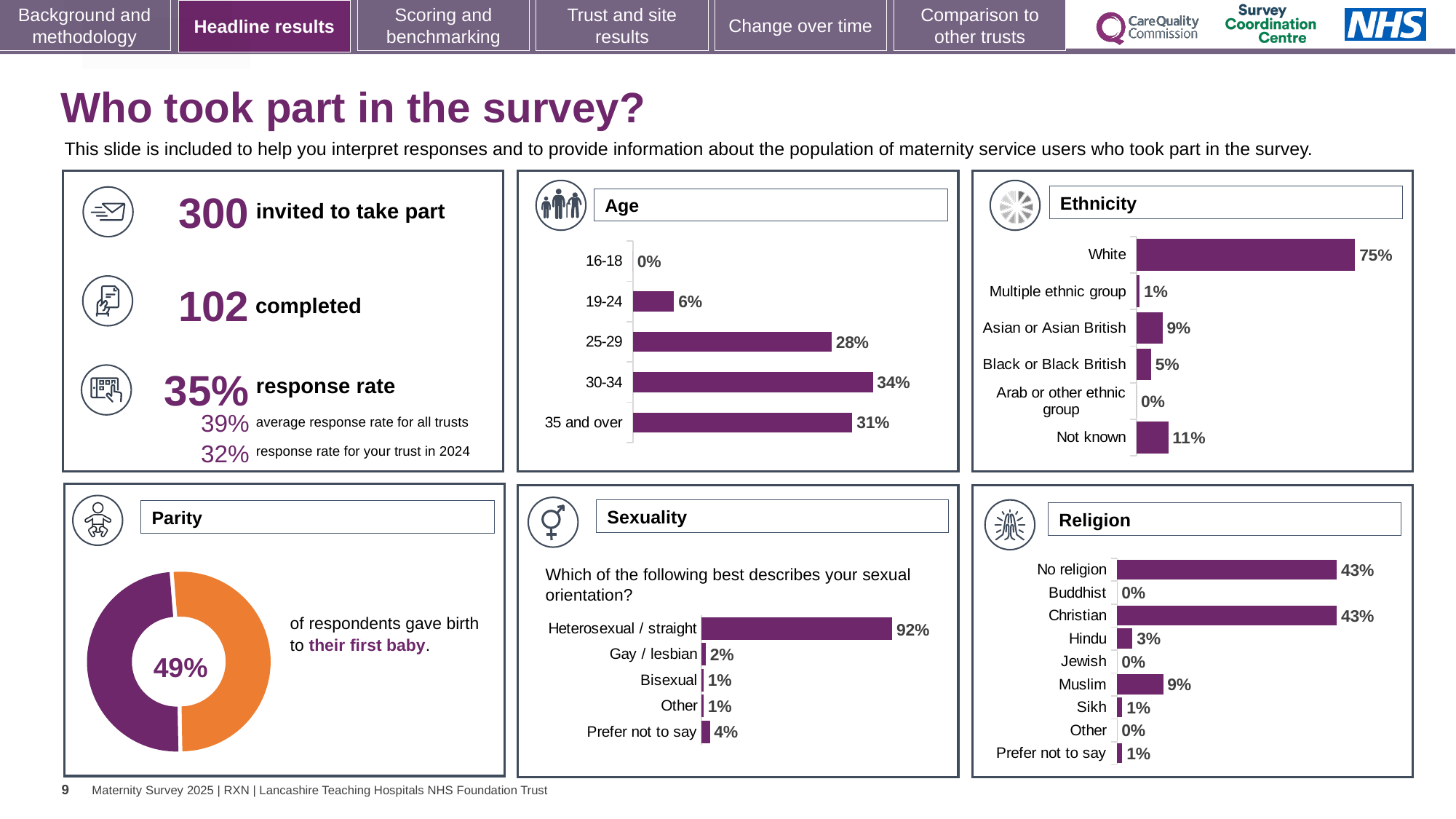
In the Age chart, what is the difference between the 25-29 and 19-24 percentages? 22% In the Age chart, which age group has the highest percentage? 30-34 In the Sexuality chart, what percentage of respondents answered Heterosexual / straight? 92% What kind of chart is the Parity chart? Donut chart In the Parity chart, what percentage of respondents gave birth to their first baby? 49% In the Ethnicity chart, which category has the highest percentage? White In the Ethnicity chart, what percentage of respondents were White? 75% In the Ethnicity chart, how many ethnicity categories are shown? 6 In the Religion chart, what percentage of respondents were Muslim? 9% In the Ethnicity chart, which is larger: Asian or Asian British or Black or Black British? Asian or Asian British In the Religion chart, how many religion categories are listed? 9 In the Age chart, what percentage of respondents were aged 30-34? 34%